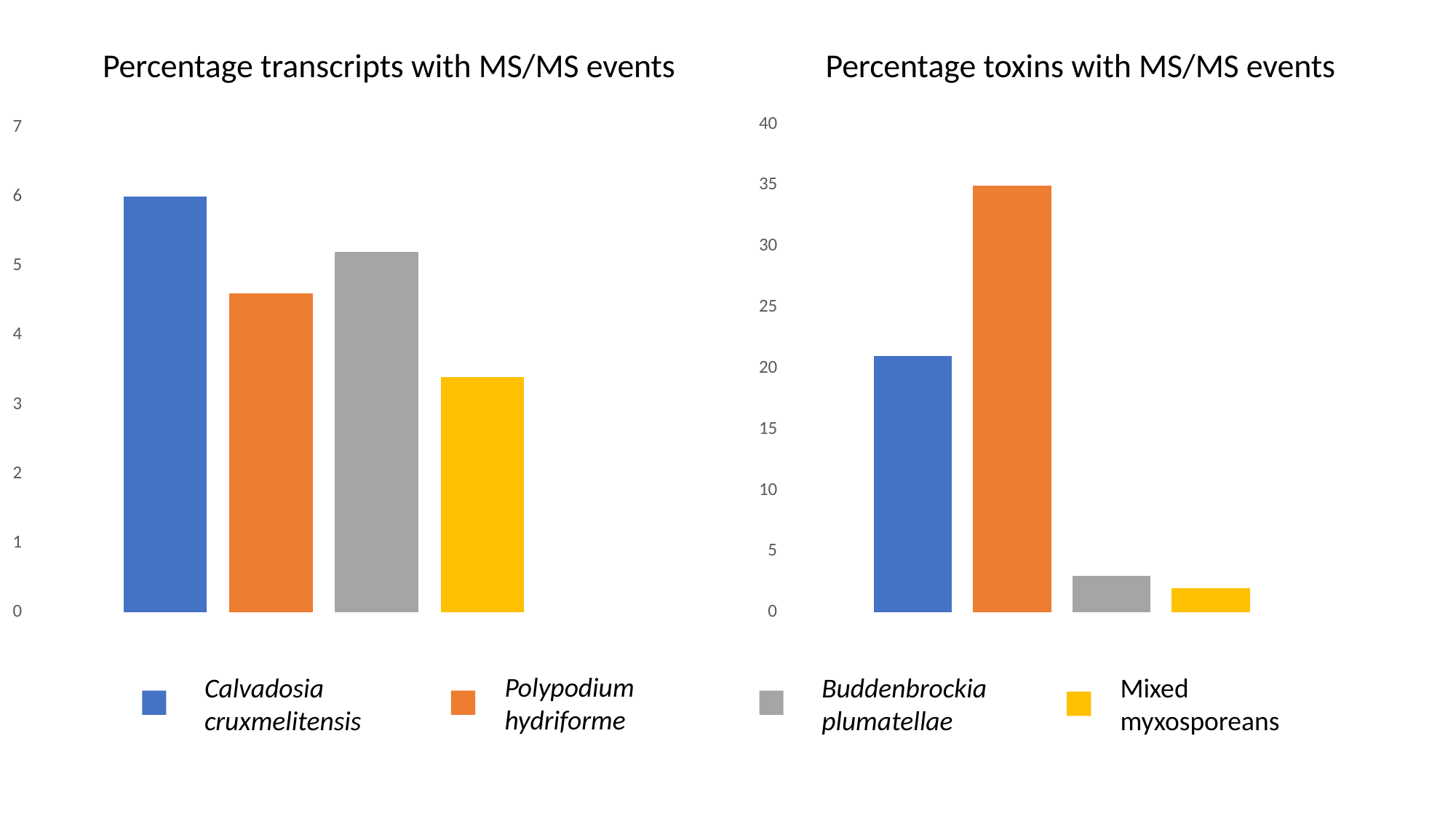
In the 'Percentage toxins with MS/MS events' chart, which group has the lowest bar? Mixed myxosporeans In the 'Percentage toxins with MS/MS events' chart, which species has the highest bar? Polypodium hydriforme In the 'Percentage toxins with MS/MS events' chart, is the value for Buddenbrockia plumatellae greater or less than 5? less In the 'Percentage transcripts with MS/MS events' chart, is the value for Mixed myxosporeans greater or less than 3? greater In the 'Percentage transcripts with MS/MS events' chart, which group has the lowest bar? Mixed myxosporeans How many bars are shown in the 'Percentage toxins with MS/MS events' chart? 4 In the 'Percentage toxins with MS/MS events' chart, which is larger: the value for Calvadosia cruxmelitensis or Polypodium hydriforme? Polypodium hydriforme In the 'Percentage toxins with MS/MS events' chart, is the value for Calvadosia cruxmelitensis greater or less than 20? greater What type of chart is the 'Percentage transcripts with MS/MS events' chart? Bar chart In the 'Percentage transcripts with MS/MS events' chart, which species has the highest bar? Calvadosia cruxmelitensis In the 'Percentage transcripts with MS/MS events' chart, which is larger: the value for Polypodium hydriforme or Buddenbrockia plumatellae? Buddenbrockia plumatellae